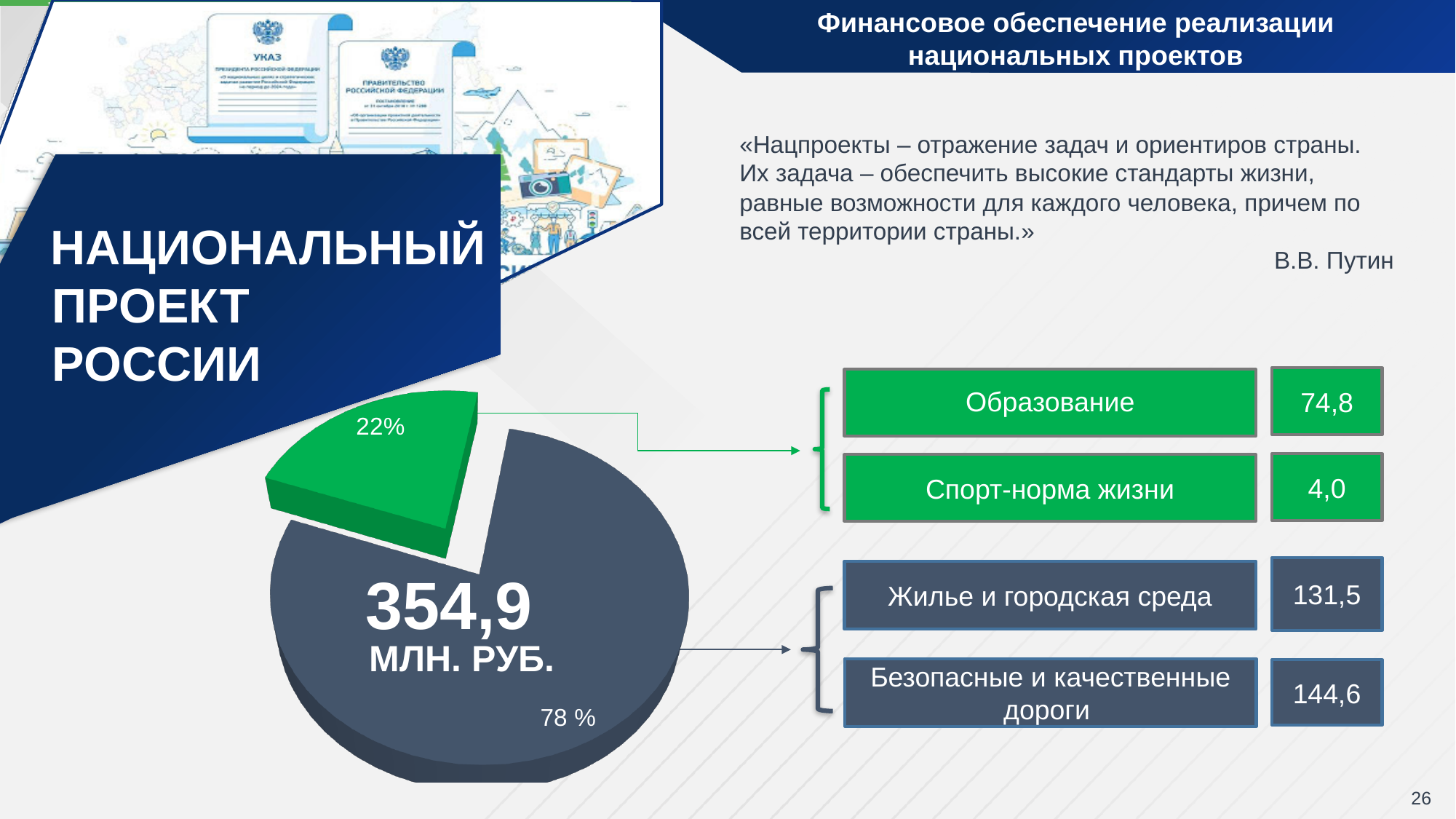
What share of the pie does the dark blue slice represent? 78 % What value is shown for Образование? 74,8 What value is shown for Жилье и городская среда? 131,5 How many slices does the pie chart have? 2 What total amount is printed in the centre of the pie chart? 354,9 млн. руб. Which of the four listed national projects has the highest value? Безопасные и качественные дороги Which slice of the pie is larger, the green one or the dark blue one? The dark blue one What value is shown for Безопасные и качественные дороги? 144,6 What kind of chart is shown on the slide? Pie chart What is the difference between the values for Безопасные и качественные дороги and Жилье и городская среда? 13,1 What share of the pie does the green slice represent? 22% What value is shown for Спорт-норма жизни? 4,0